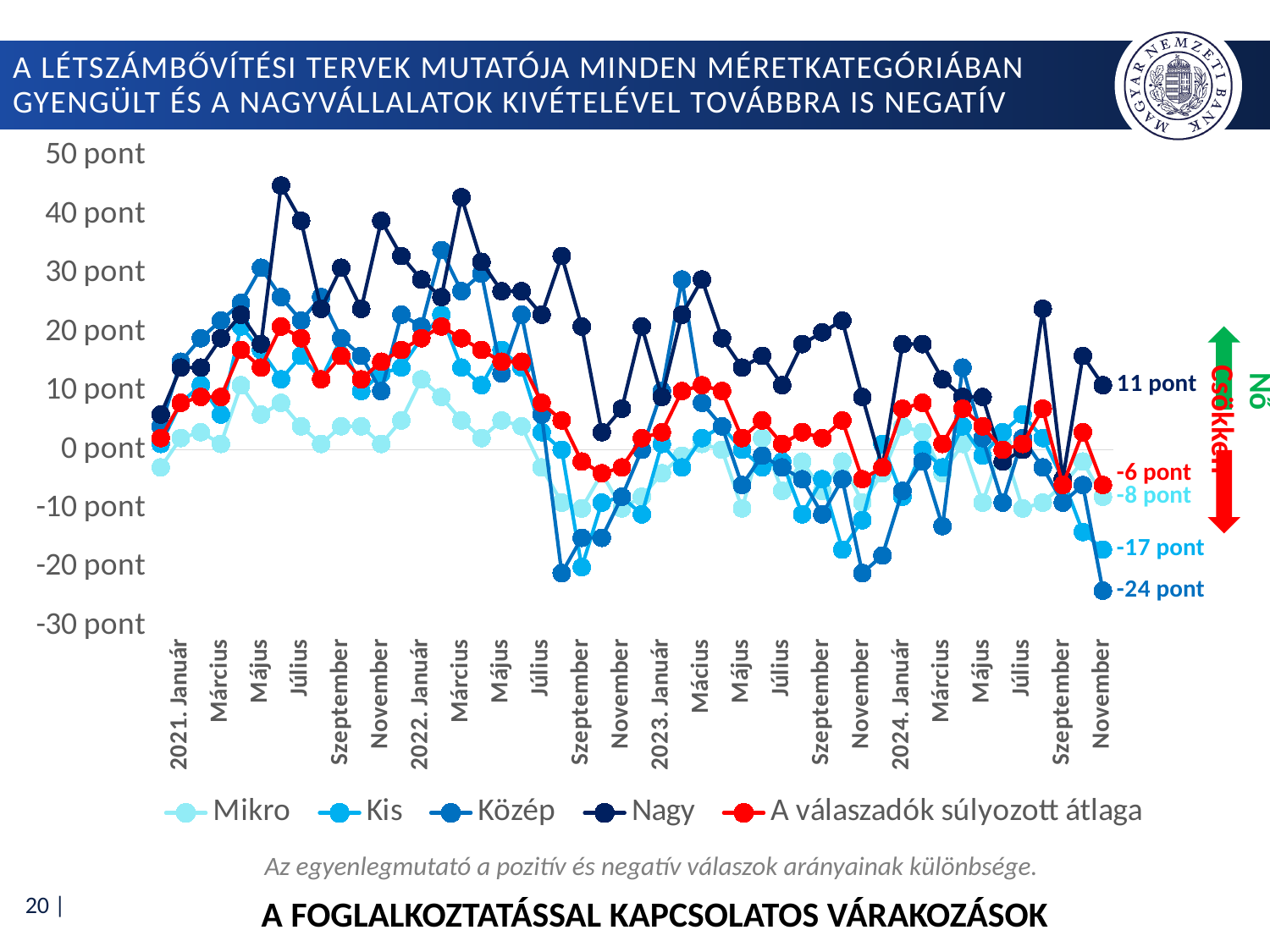
Which series has the highest value at the last point (November 2024)? Nagy What is the value for Közép at the last point (November 2024)? -24 pont What is the value for Kis at the last point (November 2024)? -17 pont What is the value for Mikro at the last point (November 2024)? -8 pont Which series has the lowest value at the last point (November 2024)? Közép What is the value of 'A válaszadók súlyozott átlaga' at the last point (November 2024)? -6 pont Is the peak value of the Nagy series in mid-2021 greater or less than 40 pont? greater How many series does the legend list? 5 What is the value for Nagy at the last point (November 2024)? 11 pont What kind of chart is shown on the slide? Line chart What is the difference between the Nagy and Közép values at the last point (November 2024)? 35 pont At the last point (November 2024), which is larger: the value for Mikro or the value for Kis? Mikro